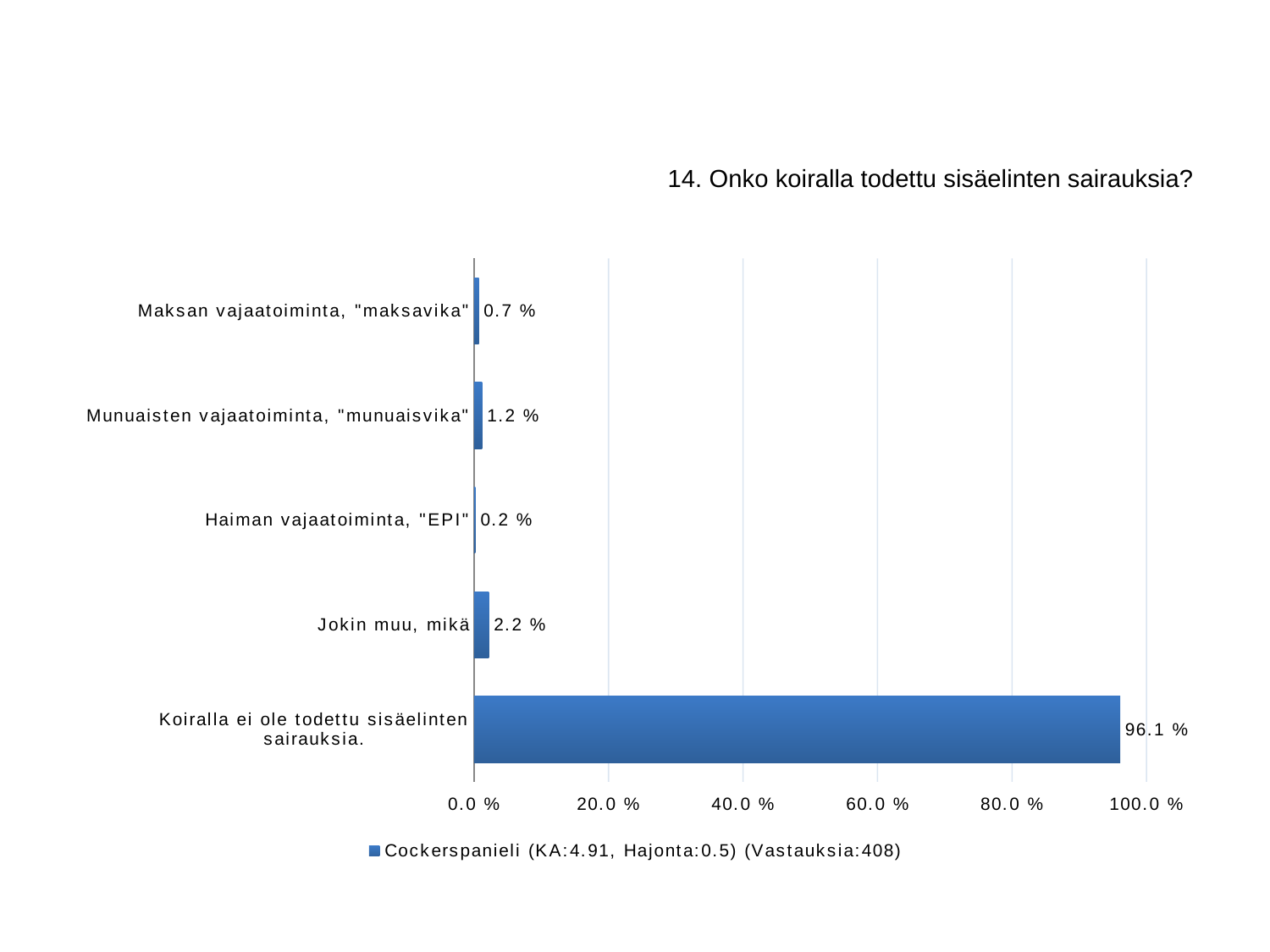
What kind of chart is shown on the slide? Bar chart Which category has the highest value? Koiralla ei ole todettu sisäelinten sairauksia. Which category has the lowest value? Haiman vajaatoiminta, "EPI" Which is larger: the value for "Munuaisten vajaatoiminta, "munuaisvika"" or for "Maksan vajaatoiminta, "maksavika""? Munuaisten vajaatoiminta, "munuaisvika" What is the difference between the values for "Jokin muu, mikä" and "Munuaisten vajaatoiminta, "munuaisvika""? 1.0 % What is the value for "Haiman vajaatoiminta, "EPI""? 0.2 % What is the value for "Maksan vajaatoiminta, "maksavika""? 0.7 % What is the title of the chart? 14. Onko koiralla todettu sisäelinten sairauksia? What is the value for "Koiralla ei ole todettu sisäelinten sairauksia."? 96.1 % What is the value for "Jokin muu, mikä"? 2.2 % How many categories are shown in the chart? 5 What is the value for "Munuaisten vajaatoiminta, "munuaisvika""? 1.2 %